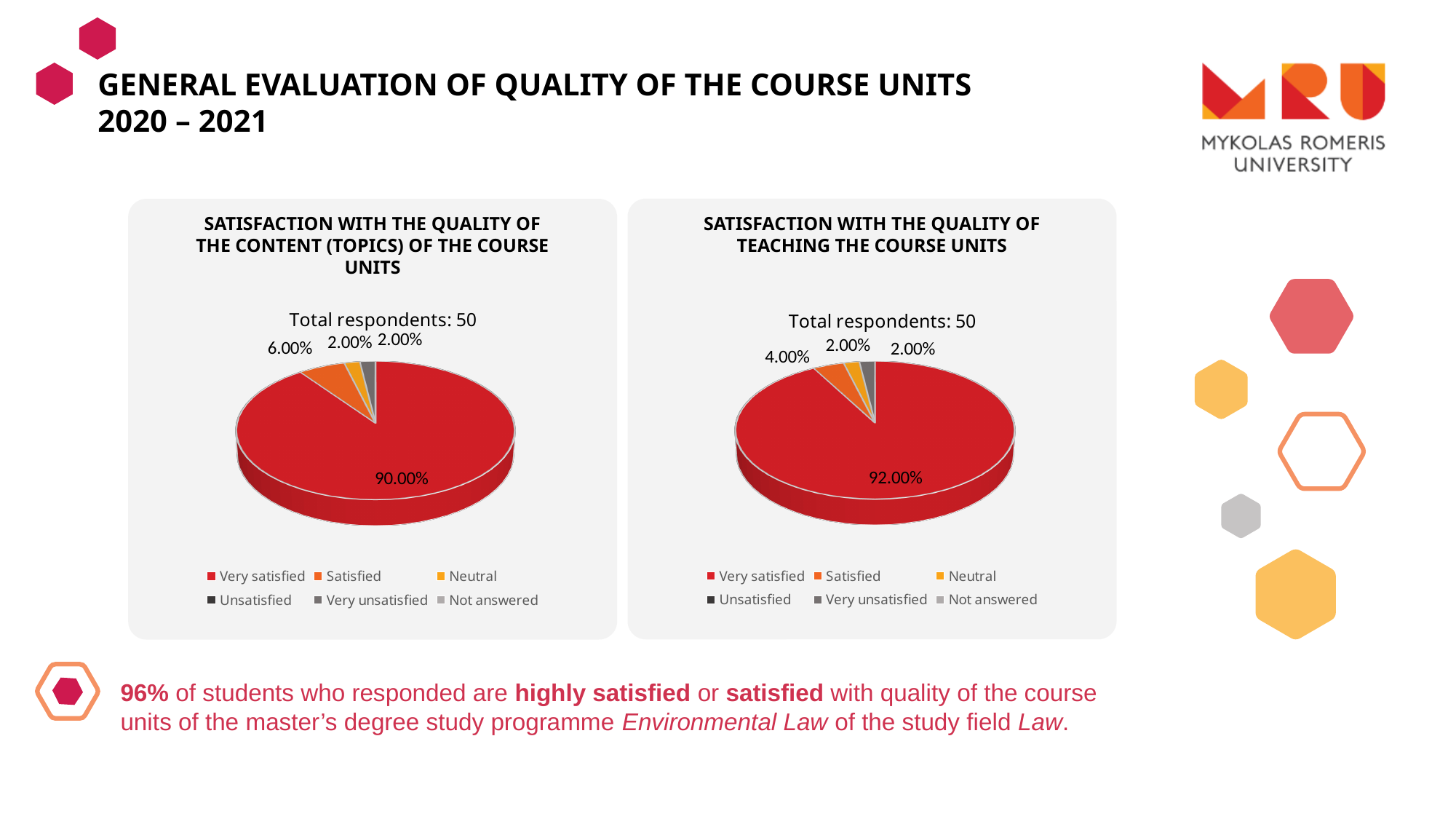
Which chart shows a larger share of very satisfied respondents, the content chart or the teaching chart? The teaching chart In the left chart (content of the course units), what percentage of respondents were neutral? 2.00% How many total respondents are reported for the right chart (teaching the course units)? 50 In the right chart (teaching the course units), which category has the largest share? Very satisfied In the left chart (content of the course units), is the share of satisfied respondents larger than the share of neutral respondents? Yes What is the difference between the very satisfied share in the teaching chart and the very satisfied share in the content chart? 2.00% How many categories does the legend of the left chart (content of the course units) list? 6 In the right chart (teaching the course units), what percentage of respondents were satisfied? 4.00% In the chart titled 'Satisfaction with the quality of the content (topics) of the course units', what share of respondents were very satisfied? 90.00% In the left chart (content of the course units), what percentage of respondents were satisfied? 6.00% What type of chart is used in the 'Satisfaction with the quality of teaching the course units' panel? Pie chart In the chart titled 'Satisfaction with the quality of teaching the course units', what share of respondents were very satisfied? 92.00%